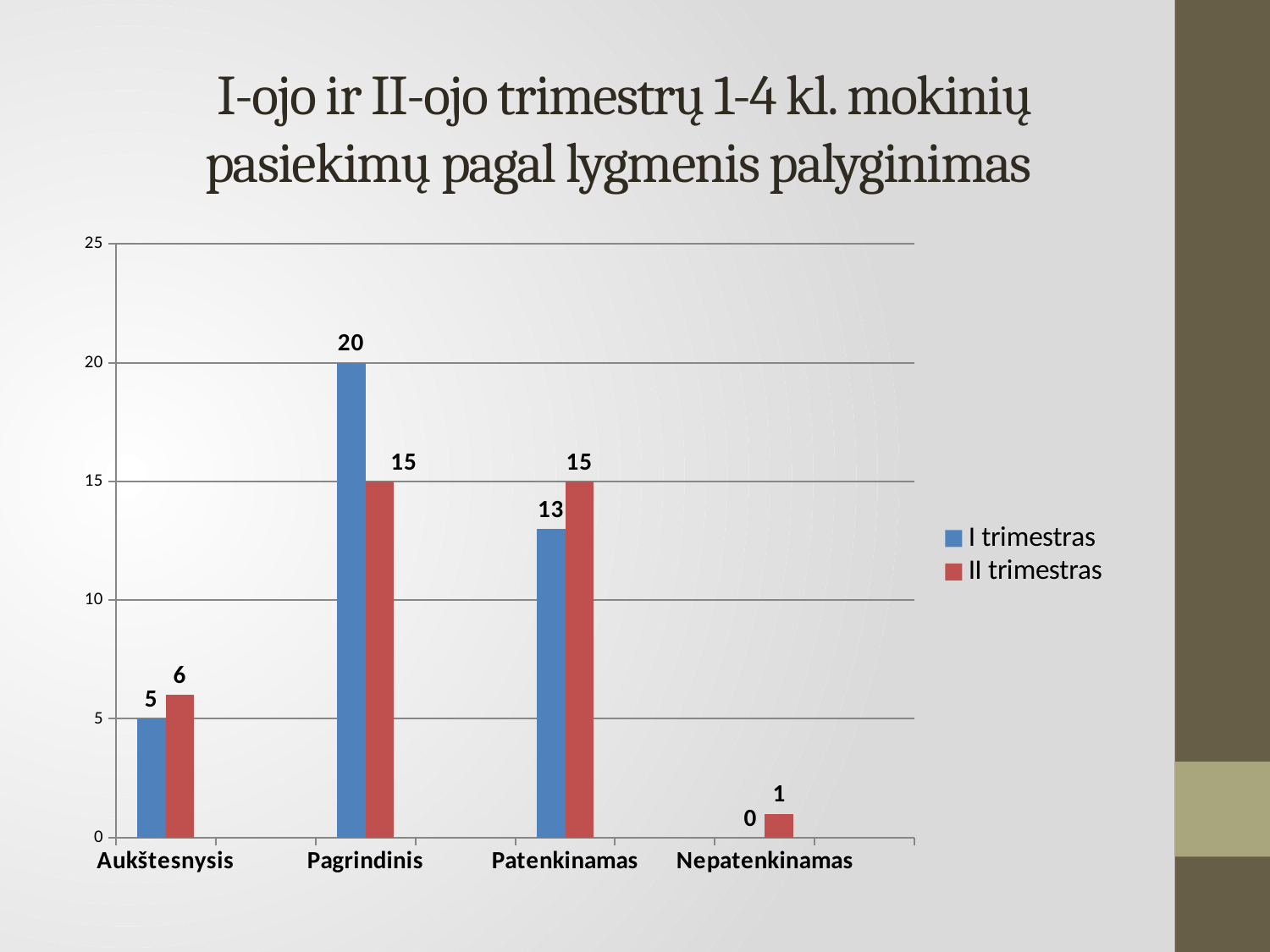
What is the value for Patenkinamas in the II trimestras series? 15 How many categories are shown on the x axis? 4 What kind of chart is shown on the slide? Bar chart Which is larger for Patenkinamas: the I trimestras value or the II trimestras value? II trimestras Which category has the highest value in the I trimestras series? Pagrindinis What colour are the II trimestras bars? Red What is the value for Aukštesnysis in the II trimestras series? 6 What is the value for Pagrindinis in the I trimestras series? 20 How many series does the legend list? 2 What is the difference between the I trimestras and II trimestras values for Pagrindinis? 5 What is the value for Nepatenkinamas in the I trimestras series? 0 Which category has the lowest value in the II trimestras series? Nepatenkinamas